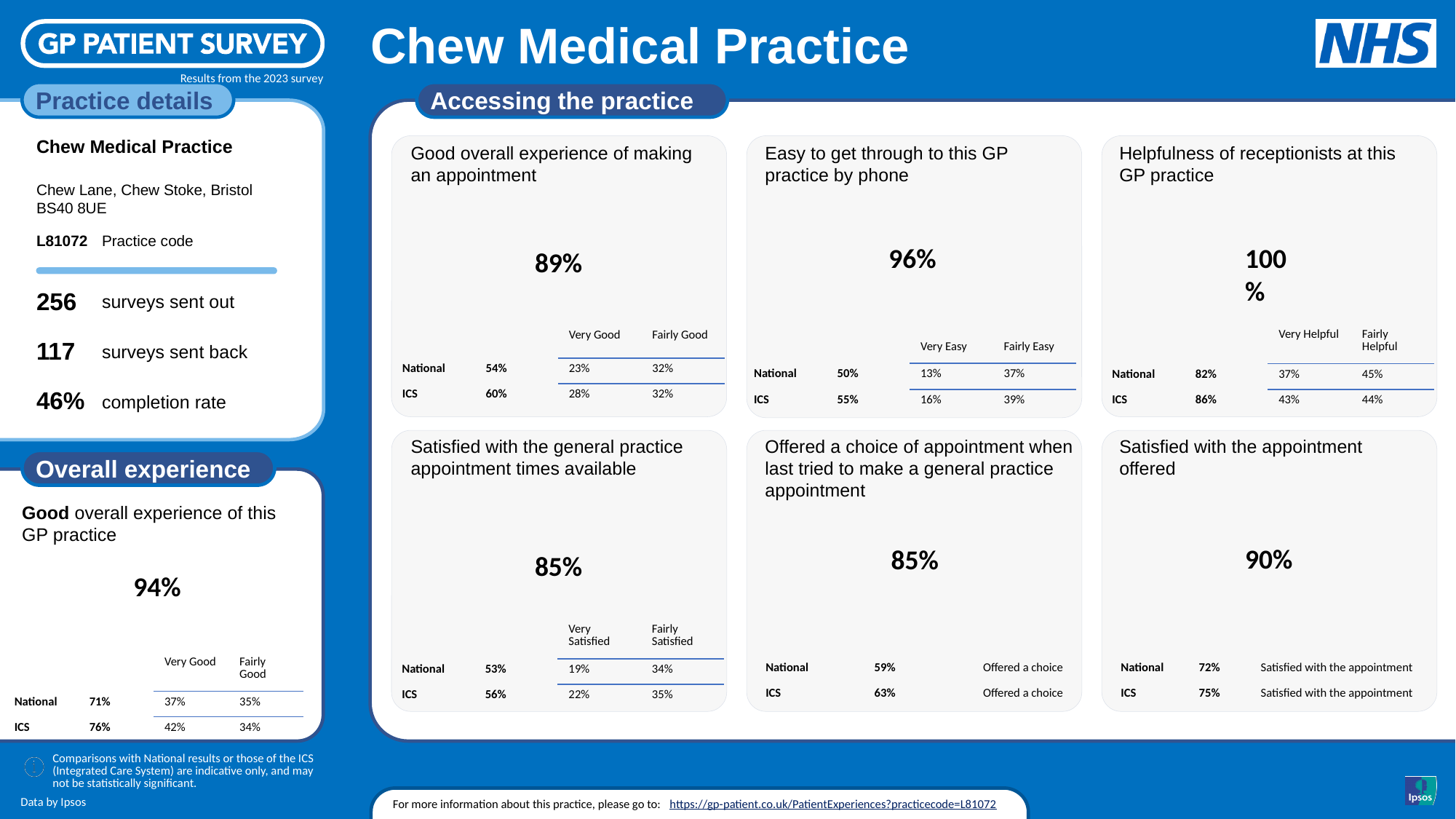
On the 'Easy to get through to this GP practice by phone' panel, what is the practice's headline percentage? 96% On the 'Satisfied with the appointment offered' panel, what is the ICS value? 75% On the 'Good overall experience of making an appointment' panel, what is the practice's headline percentage? 89% On the 'Easy to get through to this GP practice by phone' panel, what is the difference between the practice's headline value (96%) and the National value (50%)? 46% How many panels are shown under the 'Accessing the practice' heading? 6 On the 'Offered a choice of appointment' panel, what is the National value? 59% Among the six 'Accessing the practice' panels, which has the highest practice headline percentage? Helpfulness of receptionists at this GP practice On the 'Good overall experience of making an appointment' panel, which is larger: the National value or the ICS value? ICS On the 'Helpfulness of receptionists at this GP practice' panel, what is the ICS 'Very Helpful' value? 43% On the 'Good overall experience of this GP practice' panel under Overall experience, what is the practice's headline percentage? 94% On the 'Helpfulness of receptionists at this GP practice' panel, what is the practice's headline percentage? 100% On the 'Satisfied with the general practice appointment times available' panel, what is the National 'Very Satisfied' value? 19%